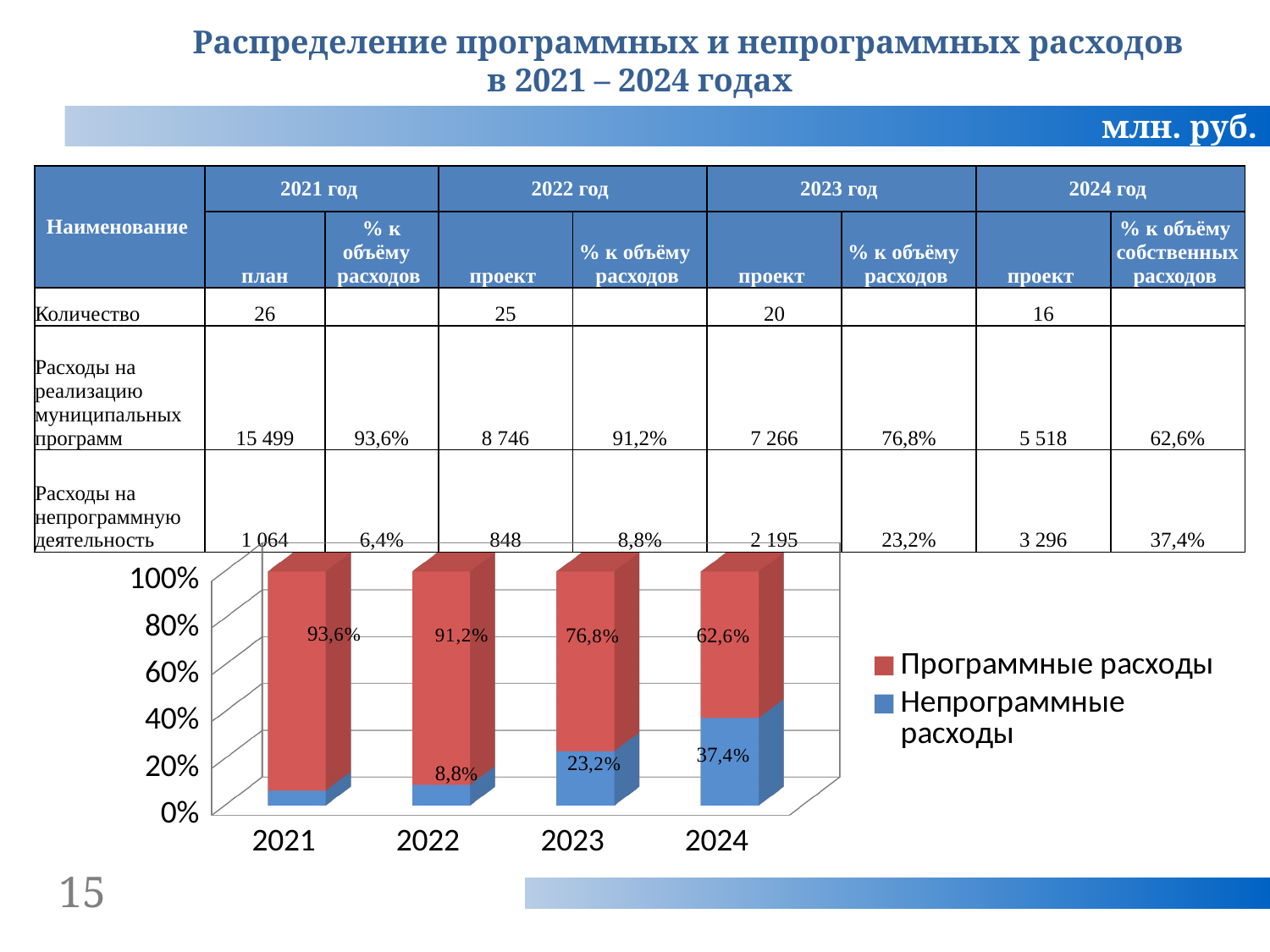
In which year is the share of Программные расходы the lowest? 2024 How many series does the chart legend list? 2 What is the value of Непрограммные расходы for 2022 in the chart? 8,8% What is the value of Программные расходы for 2023 in the chart? 76,8% What is the value of Непрограммные расходы for 2024 in the chart? 37,4% How many years are shown on the x axis of the chart? 4 What kind of chart is shown on the slide? Stacked bar chart What is the difference between the Программные расходы shares for 2022 and 2024? 28,6% Does the share of Программные расходы rise or fall from 2021 to 2024? Fall Which colour represents Непрограммные расходы in the chart? Blue What is the value of Программные расходы for 2021 in the chart? 93,6% In which year is the share of Непрограммные расходы the highest? 2024